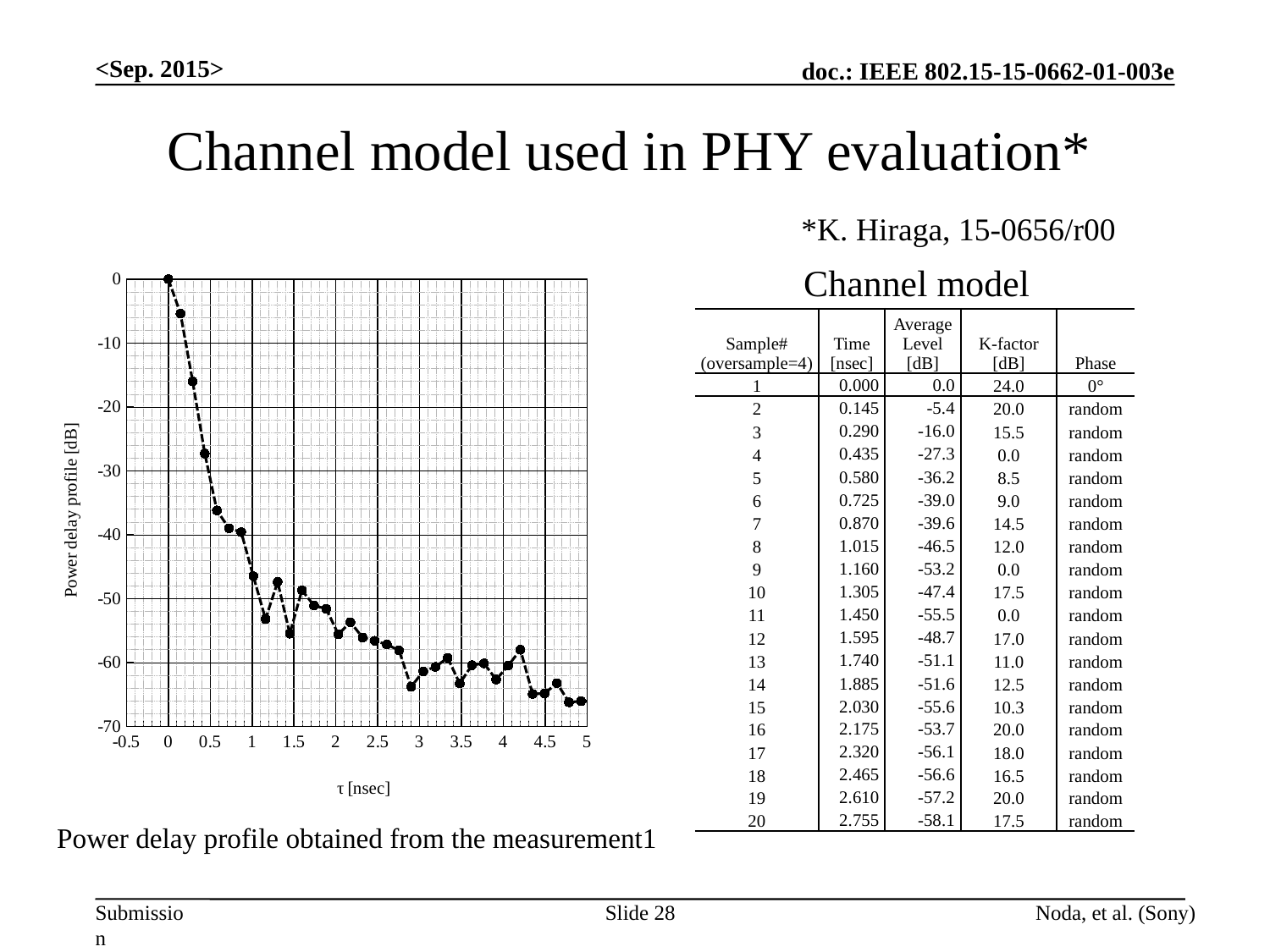
Which is larger, the power delay profile value at τ = 0 nsec or the value of the point nearest τ = 4 nsec? τ = 0 nsec Is the power delay profile value of the first point after τ = 0 greater or less than -10? greater Is the power delay profile value of the point nearest τ = 2 nsec greater or less than -50? less What is the label of the y axis of the chart? Power delay profile [dB] At which τ value does the power delay profile reach its highest value? 0 Is the power delay profile value of the point nearest τ = 3 nsec greater or less than -50? less Do the power delay profile values generally rise or fall as τ increases? fall What kind of chart is shown on the left of the slide? line chart What is the power delay profile value at τ = 0 nsec? 0 What is the label of the x axis of the chart? τ [nsec]